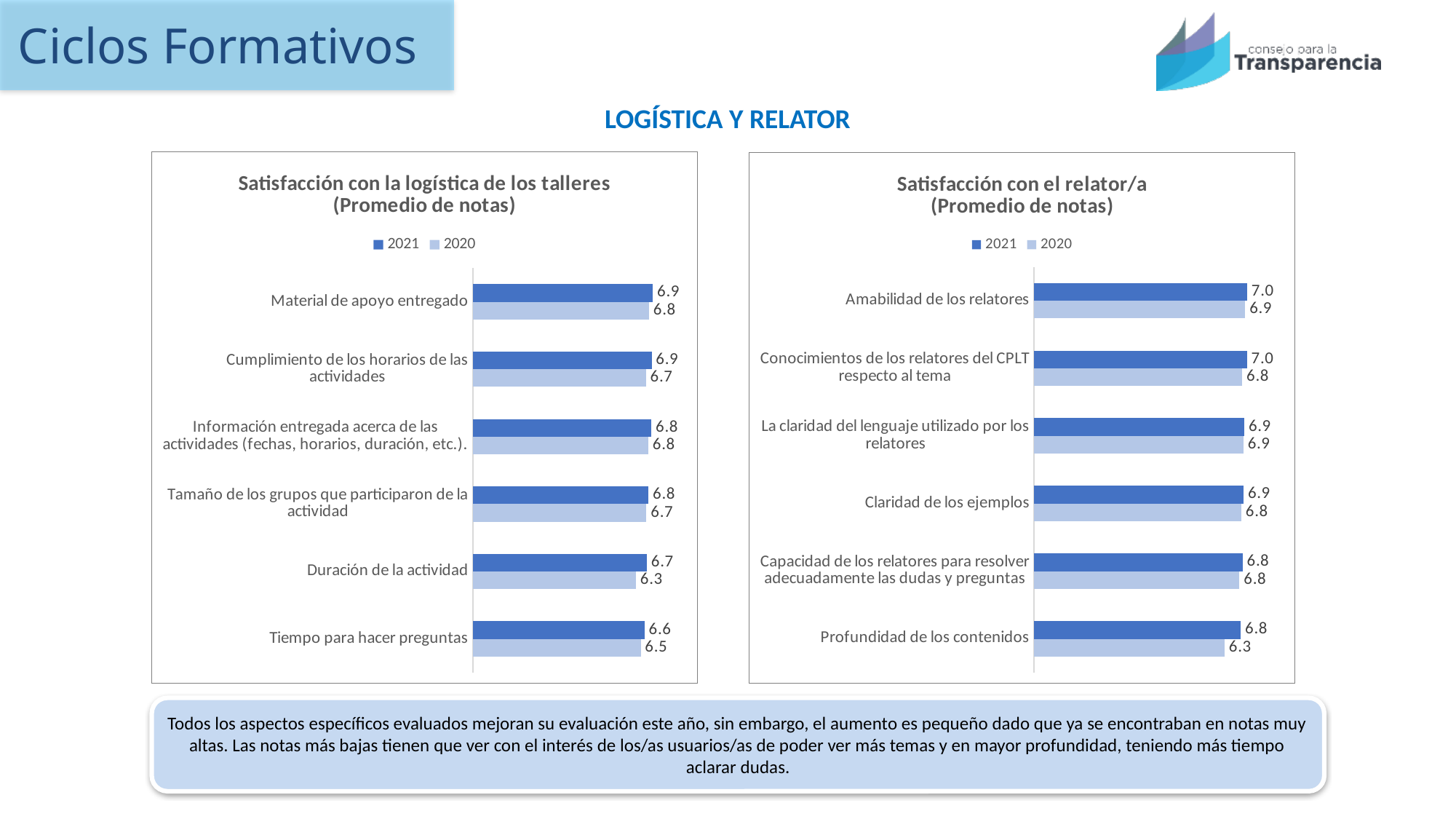
How many series does the legend of the chart 'Satisfacción con la logística de los talleres' list? 2 In the chart 'Satisfacción con el relator/a', which category has the lowest 2020 value? Profundidad de los contenidos In the chart 'Satisfacción con la logística de los talleres', which category has the lowest 2020 value? Duración de la actividad What type of chart is 'Satisfacción con el relator/a'? Bar chart In the chart 'Satisfacción con el relator/a', what is the 2020 value for 'Profundidad de los contenidos'? 6.3 In the chart 'Satisfacción con la logística de los talleres', what is the 2020 value for 'Tiempo para hacer preguntas'? 6.5 In the chart 'Satisfacción con la logística de los talleres', what is the 2021 value for 'Duración de la actividad'? 6.7 In the chart 'Satisfacción con el relator/a', what is the difference between the 2021 and 2020 values for 'Profundidad de los contenidos'? 0.5 In the chart 'Satisfacción con el relator/a', what is the 2021 value for 'Amabilidad de los relatores'? 7.0 In the chart 'Satisfacción con la logística de los talleres', which is larger for 'Cumplimiento de los horarios de las actividades': the 2021 value or the 2020 value? 2021 In the chart 'Satisfacción con la logística de los talleres', what is the difference between the 2021 and 2020 values for 'Duración de la actividad'? 0.4 How many categories are shown in the chart 'Satisfacción con el relator/a'? 6